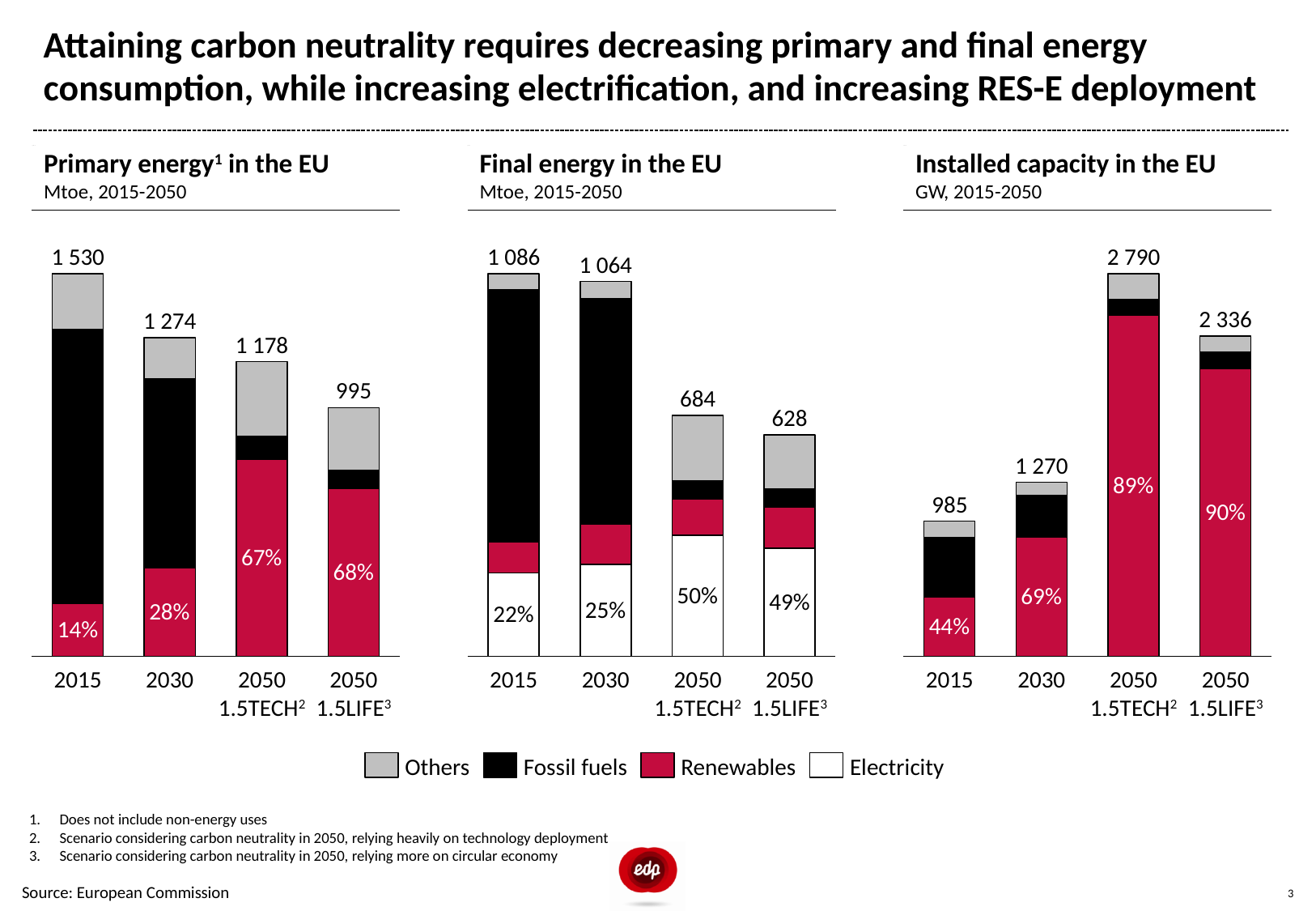
In the 'Installed capacity in the EU' chart, which category has the highest total? 2050 1.5TECH In the 'Installed capacity in the EU' chart, which category has the lowest total? 2015 In the 'Final energy in the EU' chart, which is larger, the total for 2050 1.5TECH or the total for 2050 1.5LIFE? 2050 1.5TECH What kind of chart is 'Installed capacity in the EU'? Stacked bar chart In the 'Primary energy in the EU' chart, what percentage is shown inside the 2050 1.5LIFE bar? 68% In the 'Final energy in the EU' chart, what is the total for 2050 1.5TECH? 684 In the 'Primary energy in the EU' chart, what is the total for 2015? 1 530 How many series does the legend list? 4 In the 'Primary energy in the EU' chart, what is the difference between the 2015 total and the 2030 total? 256 In the 'Final energy in the EU' chart, do the totals rise or fall from 2015 to 2050 1.5LIFE? Fall In the 'Installed capacity in the EU' chart, what is the difference between the 2050 1.5TECH total and the 2050 1.5LIFE total? 454 In the 'Final energy in the EU' chart, what percentage is shown inside the 2030 bar? 25%